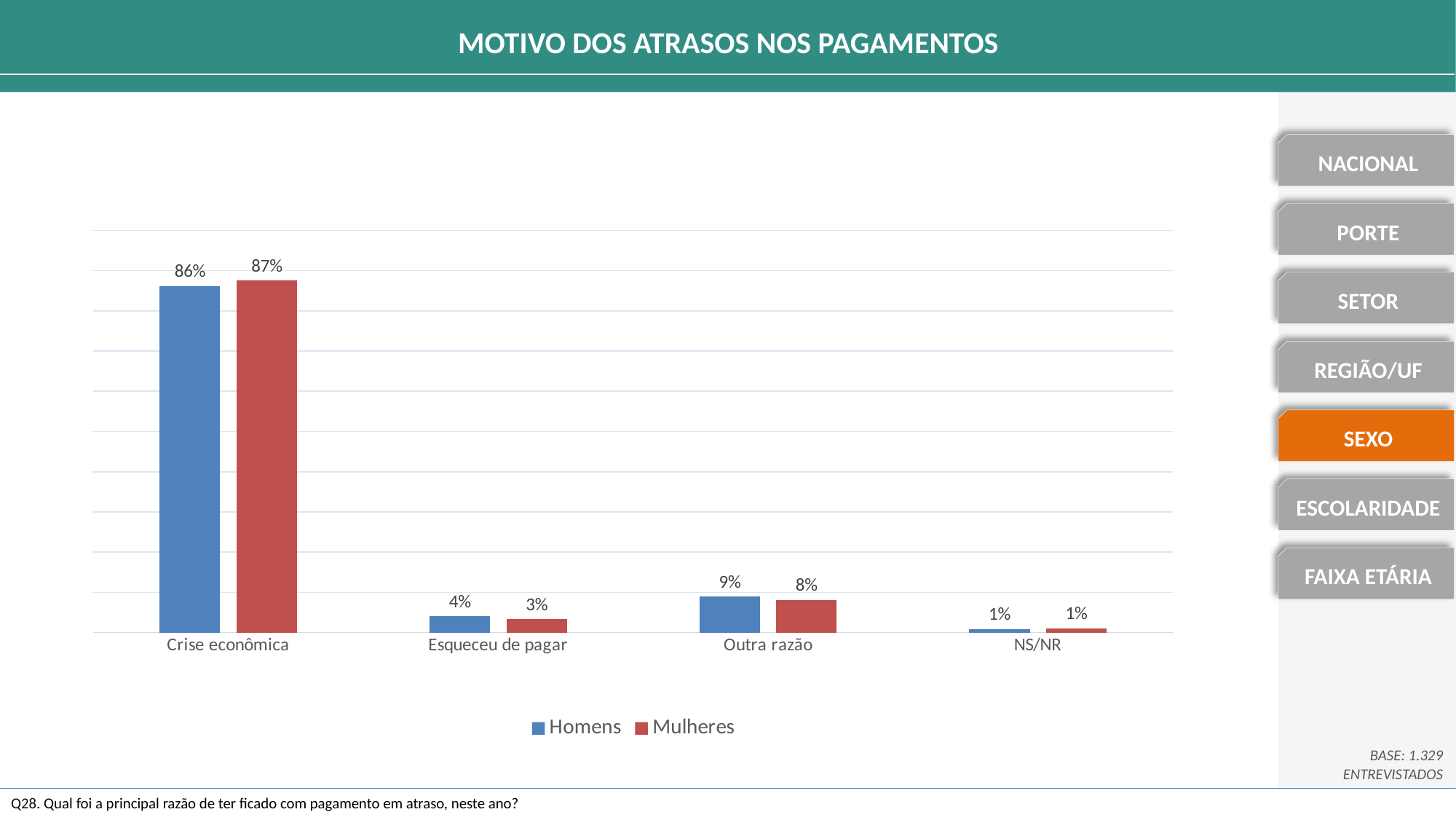
What is the value for Homens in the Outra razão category? 9% What is the title of the chart? MOTIVO DOS ATRASOS NOS PAGAMENTOS What is the difference between the Homens and Mulheres values for Outra razão? 1% What is the value for Mulheres in the Crise econômica category? 87% Which category has the highest value for Homens? Crise econômica What is the value for Mulheres in the Esqueceu de pagar category? 3% What kind of chart is shown on the slide? Bar chart How many series does the legend list? 2 Which category has the lowest value for Mulheres? NS/NR What is the value for Homens in the Crise econômica category? 86% How many categories are shown on the x axis? 4 Which is larger for Esqueceu de pagar, the Homens value or the Mulheres value? Homens